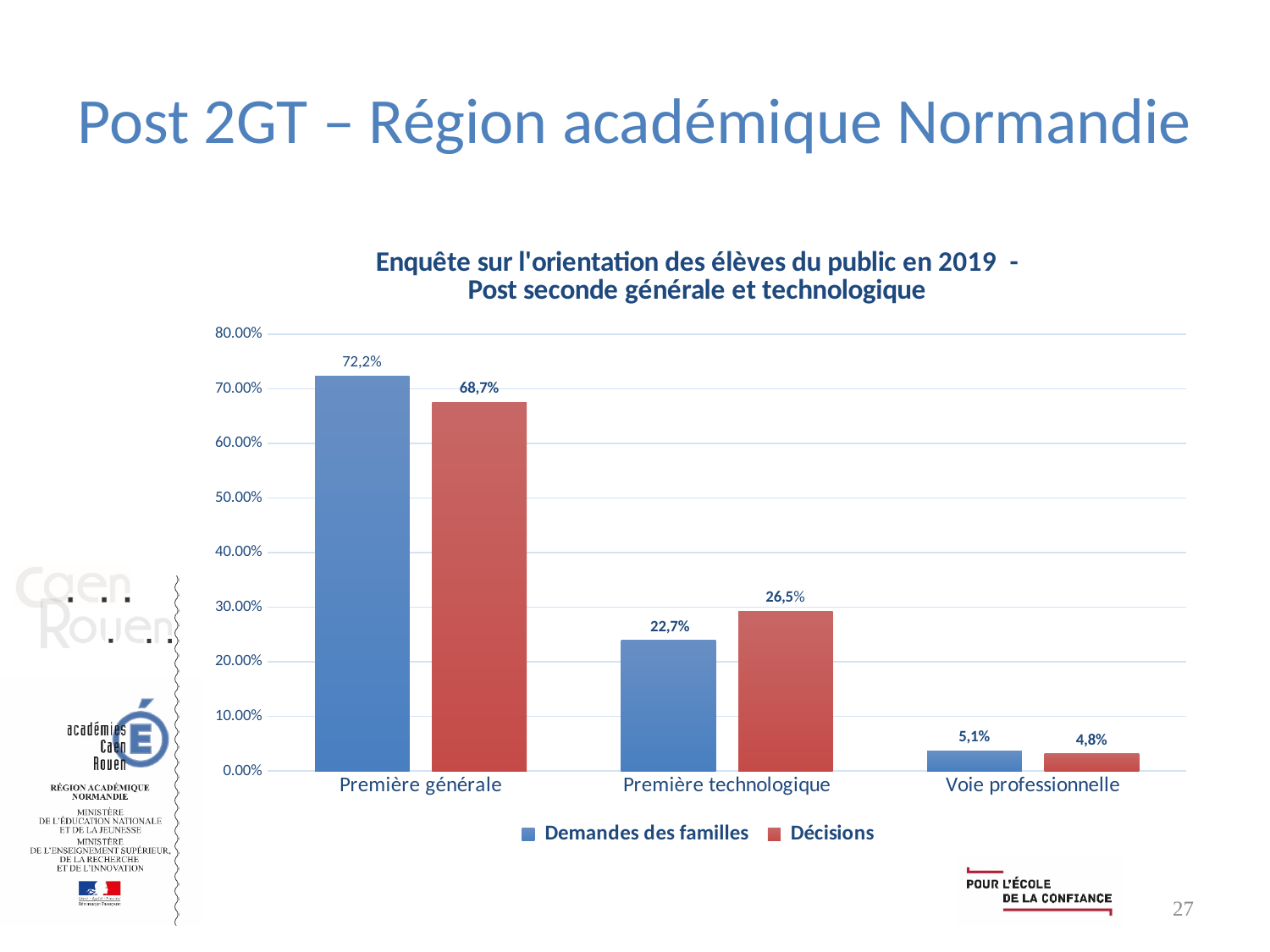
What is the value of Décisions for Première technologique? 26,5% Which category has the lowest value for Demandes des familles? Voie professionnelle How many categories are shown on the x axis? 3 For Première technologique, which is larger: Demandes des familles or Décisions? Décisions What is the value of Demandes des familles for Première générale? 72,2% Is the value of Décisions for Première générale greater or less than 60.00%? greater What is the difference between Demandes des familles and Décisions for Première générale? 3,5% What is the value of Décisions for Voie professionnelle? 4,8% What kind of chart is shown on the slide? Bar chart Which category has the highest value for Décisions? Première générale How many series does the legend list? 2 Which colour represents the Décisions series? Red